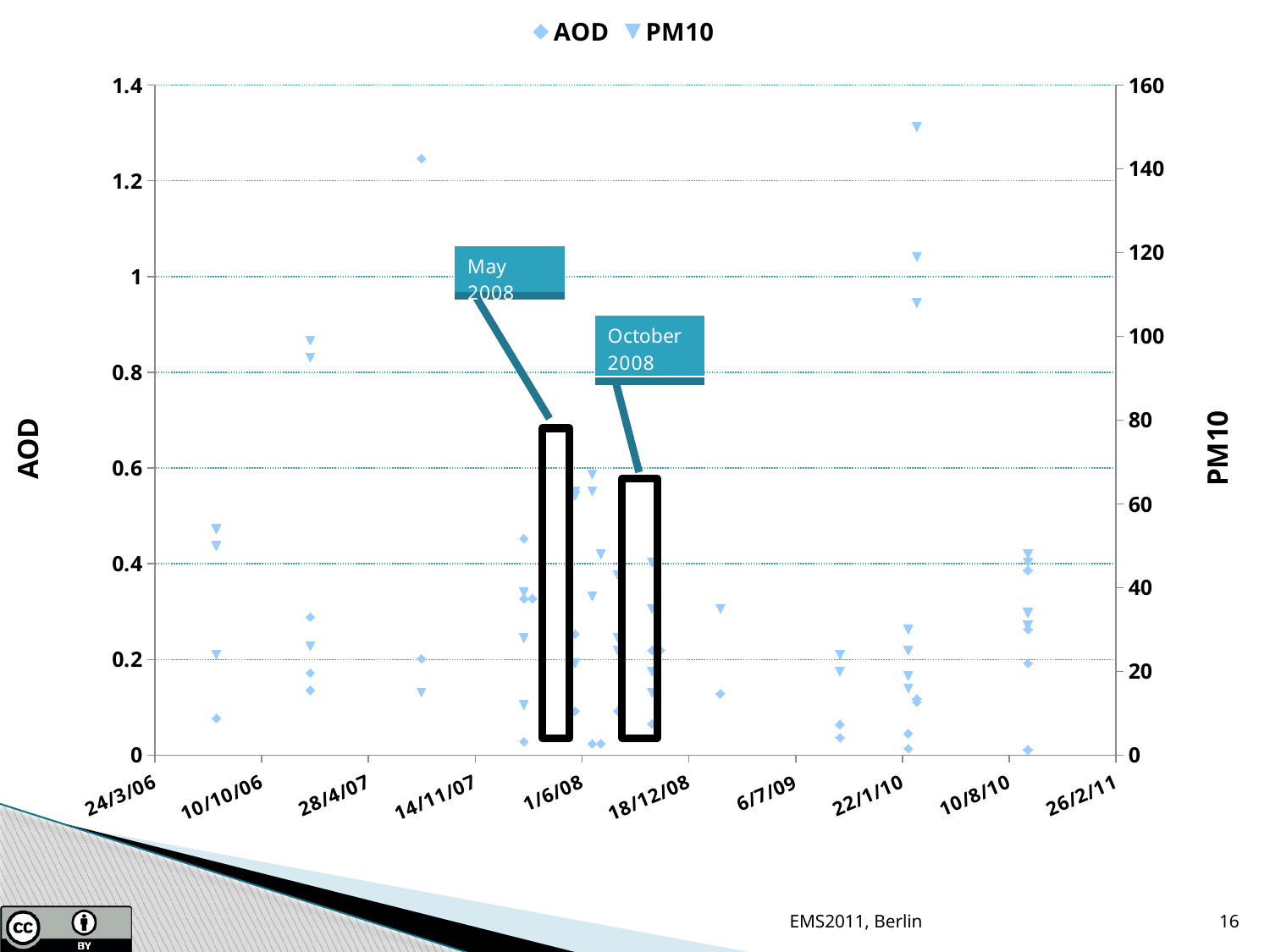
What is the last date label on the x axis? 26/2/11 Is the highest PM10 point on the chart greater or less than 140? greater Is the highest AOD point on the chart greater or less than 1? greater What is the first date label on the x axis? 24/3/06 What is the title of the left vertical axis? AOD How many series does the legend list? 2 How many date labels are shown along the x axis? 10 What are the two series named in the legend? AOD and PM10 What kind of chart is shown on the slide? scatter chart What is the maximum value shown on the left (AOD) axis? 1.4 What is the maximum value shown on the right (PM10) axis? 160